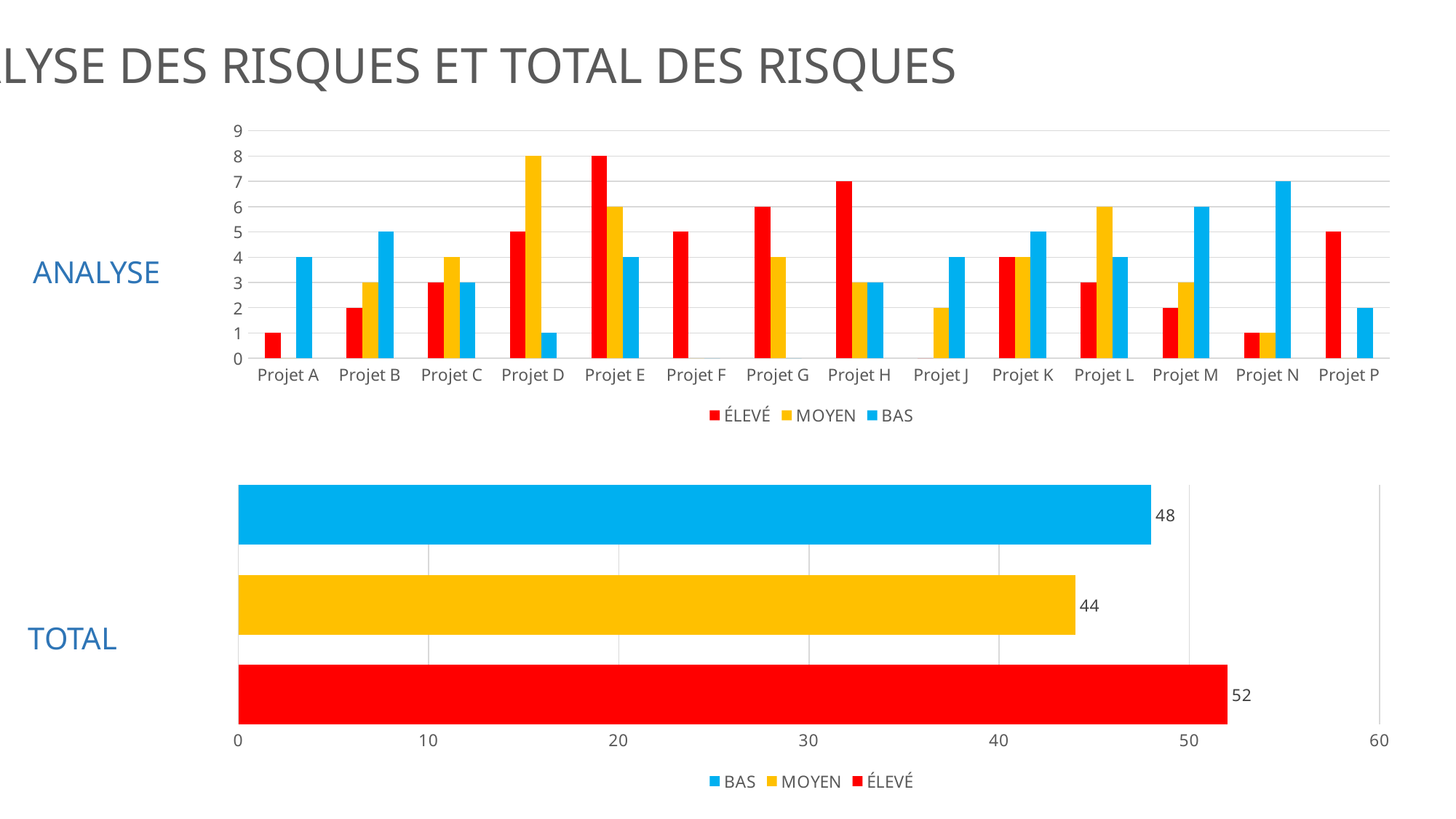
In the TOTAL chart, what is the value for ÉLEVÉ? 52 In the ANALYSE chart, how many series does the legend list? 3 In the ANALYSE chart, how many projects are shown on the x axis? 14 In the TOTAL chart, which category has the highest value? ÉLEVÉ In the TOTAL chart, which category has the lowest value? MOYEN In the TOTAL chart, what is the difference between the ÉLEVÉ value and the BAS value? 4 In the ANALYSE chart, what is the BAS value for Projet N? 7 In the TOTAL chart, is the value for BAS greater or less than 50? less What kind of chart is the TOTAL chart? bar chart In the ANALYSE chart, what is the ÉLEVÉ value for Projet E? 8 In the ANALYSE chart, which is larger for Projet D: the MOYEN value or the BAS value? MOYEN In the TOTAL chart, what is the value for MOYEN? 44